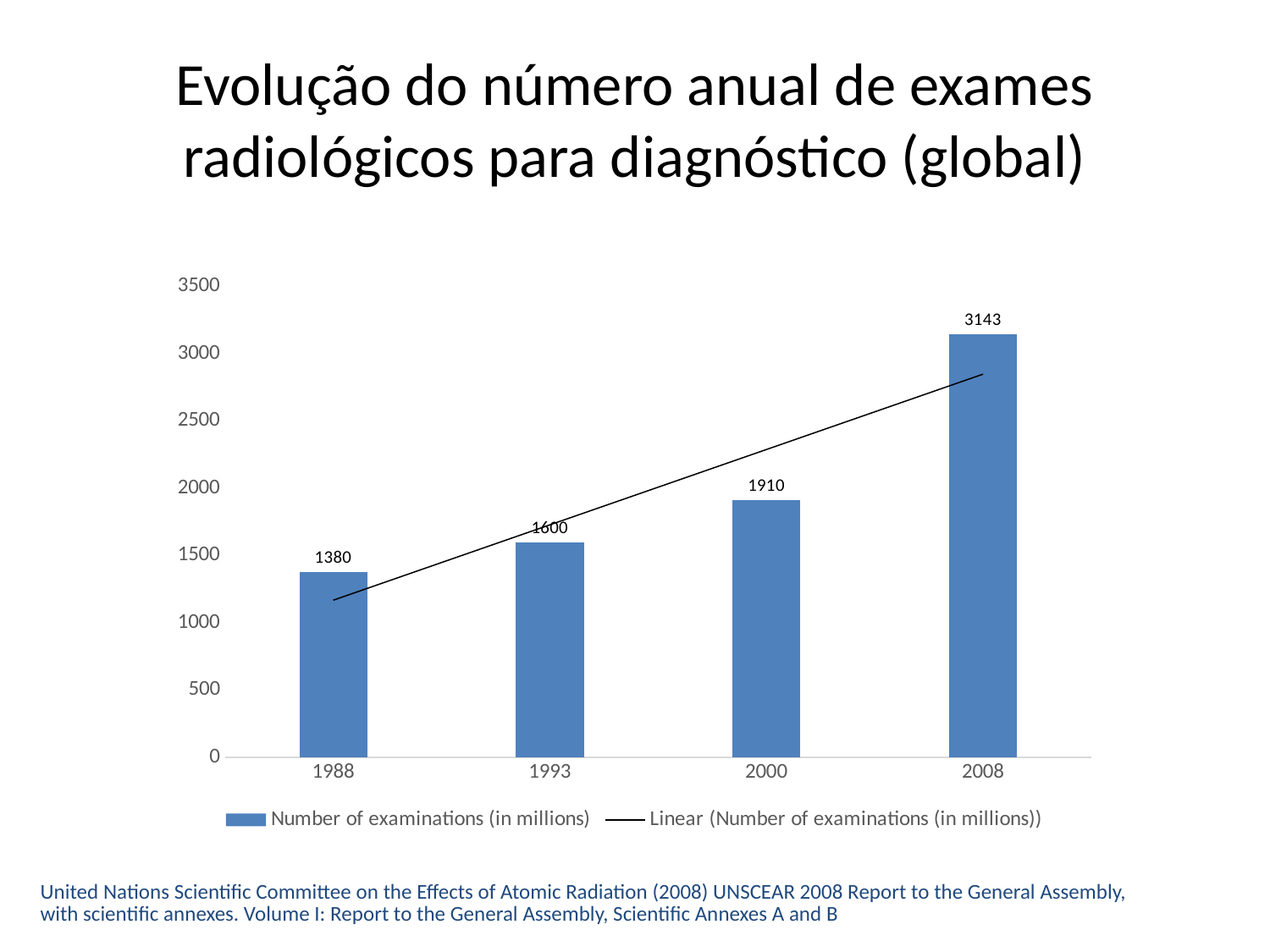
Is the value for 2008 greater or less than 3000? greater How many years are shown on the x axis of the chart? 4 What is the difference between the number of examinations in 2008 and in 1988? 1763 What is the number of examinations (in millions) for 1988? 1380 What is the number of examinations (in millions) for 2008? 3143 Which year has the highest number of examinations? 2008 Which year has a larger number of examinations, 1993 or 2000? 2000 What is the difference between the number of examinations in 2000 and in 1993? 310 What kind of chart is shown on the slide? bar chart What is the number of examinations (in millions) for 2000? 1910 Do the values rise or fall from 1988 to 2008? rise Which year has the lowest number of examinations? 1988